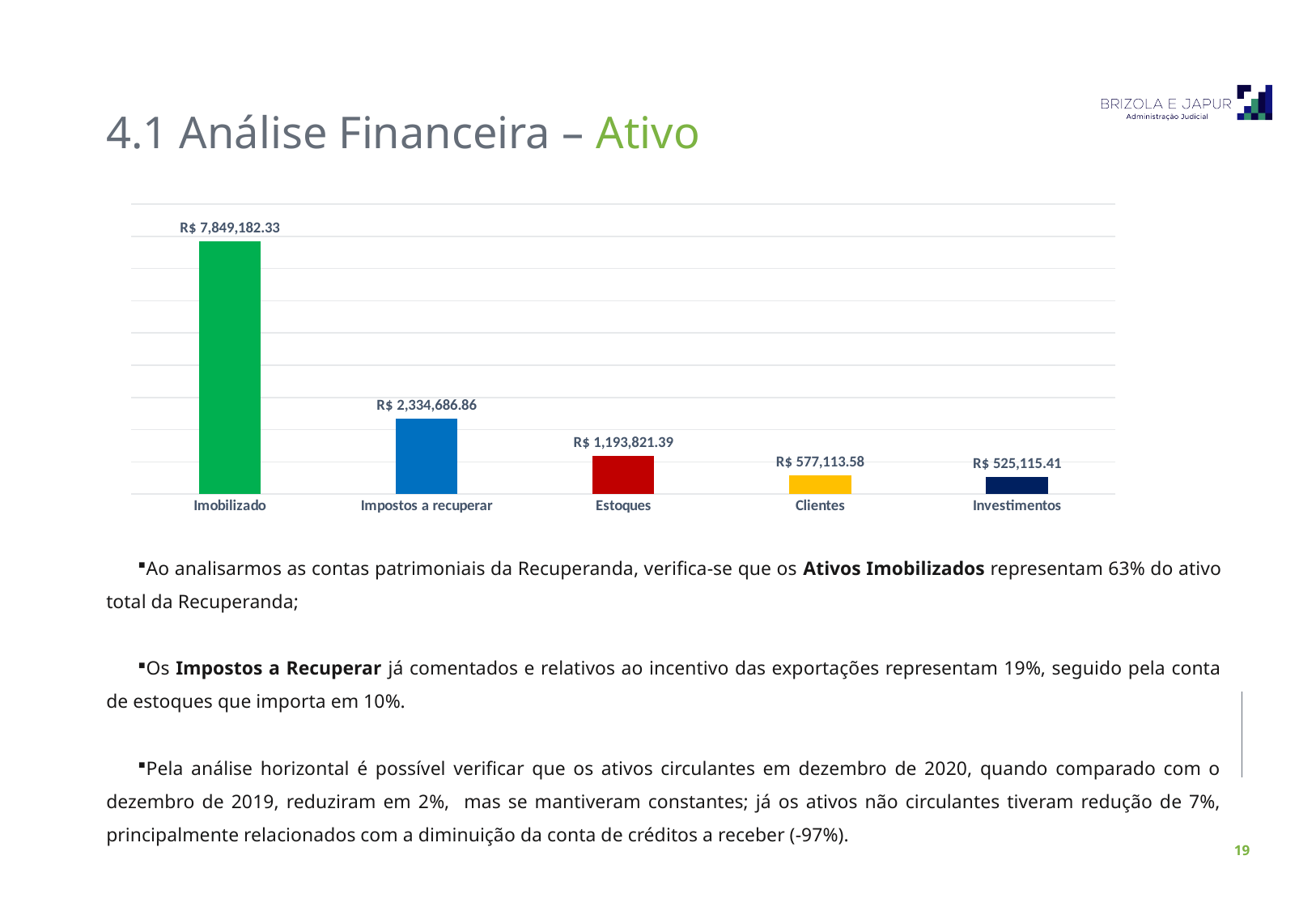
What is the value for Clientes? R$ 577,113.58 What is the value for Impostos a recuperar? R$ 2,334,686.86 What is the value for Imobilizado? R$ 7,849,182.33 Which category has the highest value? Imobilizado How many categories are shown in the chart? 5 What is the value for Estoques? R$ 1,193,821.39 Which is larger, the value for Estoques or the value for Clientes? Estoques What is the value for Investimentos? R$ 525,115.41 What is the difference between the values for Imobilizado and Impostos a recuperar? R$ 5,514,495.47 Which category has the lowest value? Investimentos What is the difference between the values for Clientes and Investimentos? R$ 51,998.17 What kind of chart is shown on the slide? Bar chart